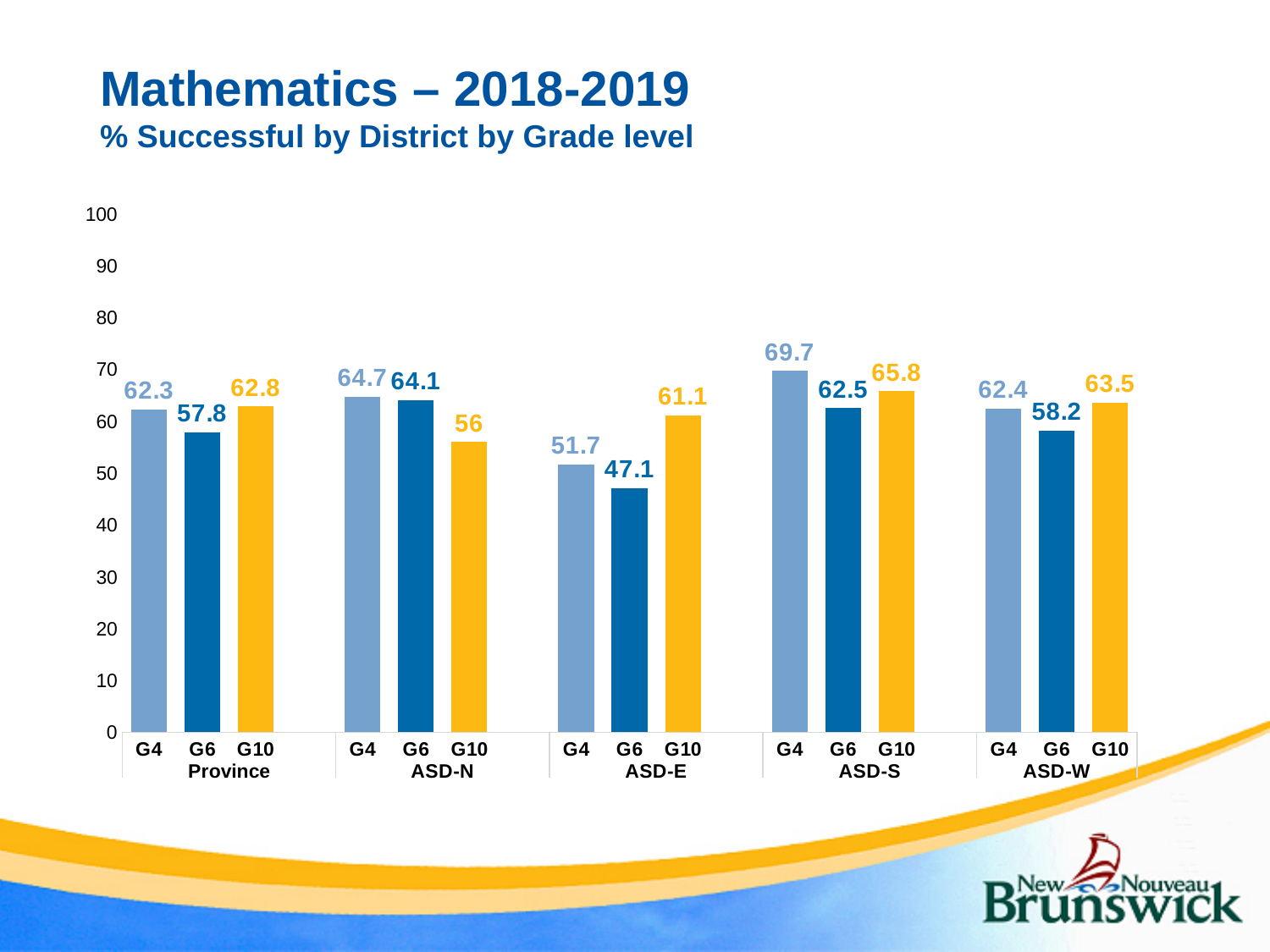
What is the difference between the G4 and G6 values for ASD-E? 4.6 What is the G6 value for ASD-E? 47.1 What is the title of the chart? Mathematics – 2018-2019 What kind of chart is shown on the slide? Bar chart What is the G6 value for Province? 57.8 Which is larger for ASD-N: the G4 value or the G10 value? G4 What is the G4 value for ASD-S? 69.7 How many districts (category groups) are shown on the x axis? 5 Is the G10 value for ASD-S greater or less than 60? greater Which district has the highest G4 value? ASD-S Which district has the lowest G6 value? ASD-E What is the G10 value for ASD-N? 56